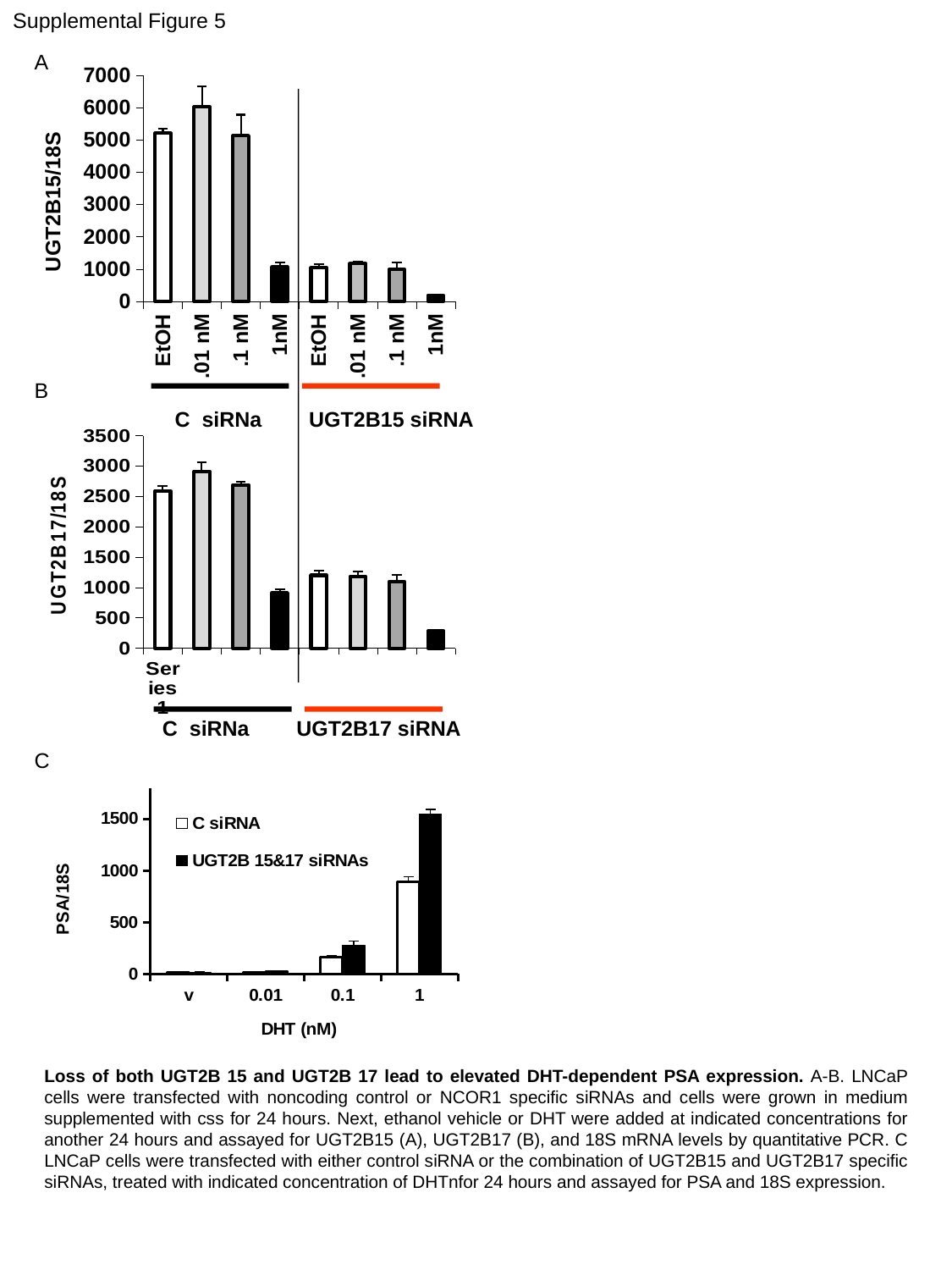
In chart A (UGT2B15/18S), is the value for 1nM under UGT2B15 siRNA greater or less than 1000? less In chart B (UGT2B17/18S), which is larger: the EtOH bar under C siRNa or the EtOH bar under UGT2B17 siRNA? EtOH under C siRNa In chart C (PSA/18S), is the C siRNA value at DHT 1 nM greater or less than 500? greater In chart A (UGT2B15/18S), which bar is the highest? .01 nM under C siRNa How many bars are plotted in chart A (UGT2B15/18S)? 8 In chart C (PSA/18S), at DHT 1 nM, which series has the larger value? UGT2B 15&17 siRNAs In chart A (UGT2B15/18S), is the value for EtOH under C siRNa greater or less than 4000? greater How many series does the legend of chart C (PSA/18S) list? 2 In chart C (PSA/18S), do the UGT2B 15&17 siRNAs values rise or fall as DHT concentration increases from v to 1? rise What is the y-axis label of chart B? UGT2B17/18S In chart B (UGT2B17/18S), which bar is the lowest? 1nM under UGT2B17 siRNA What kind of chart is chart A (UGT2B15/18S)? bar chart